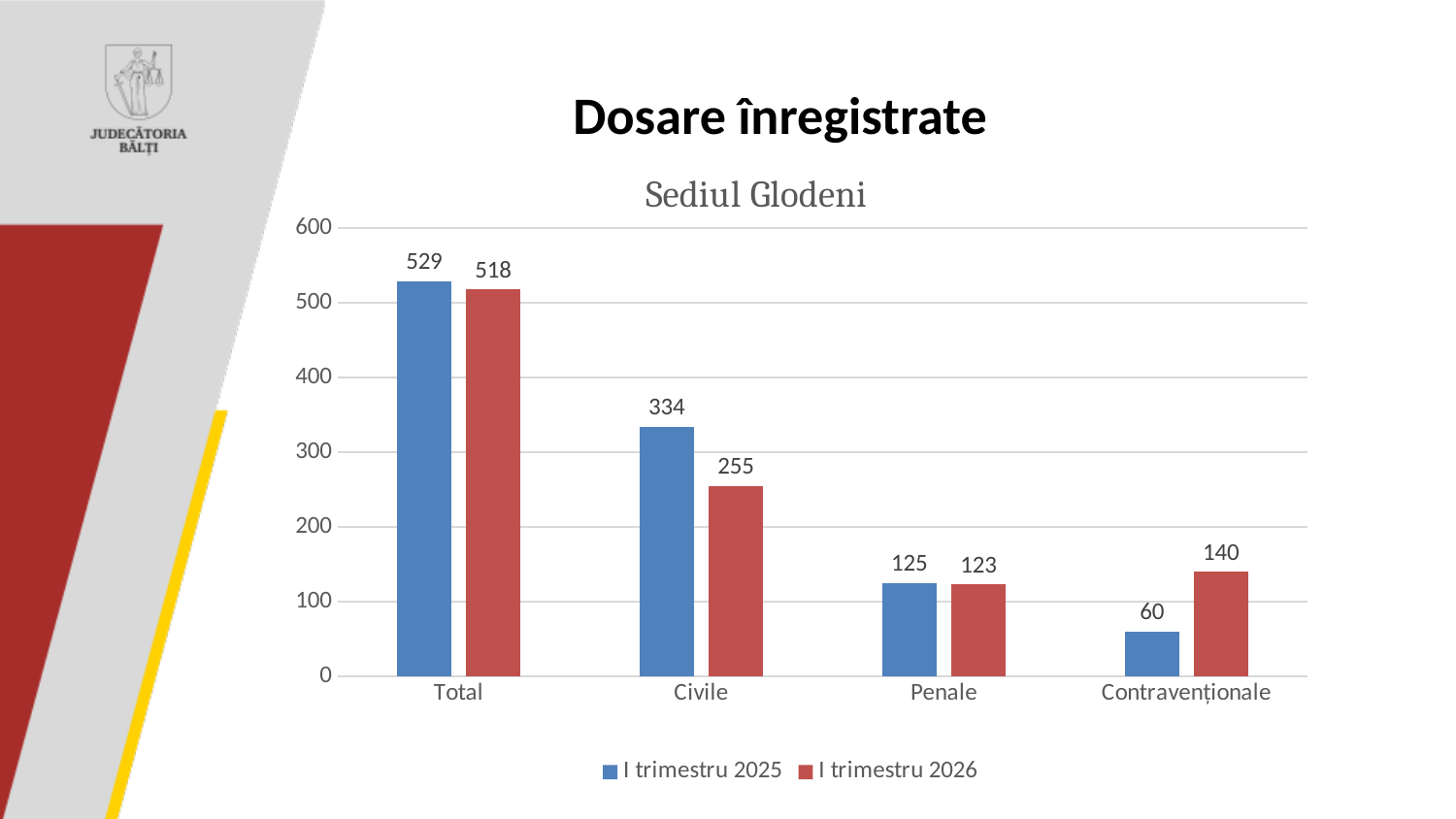
Which category has the lowest value in the I trimestru 2025 series? Contravenționale Which category has the highest value in the I trimestru 2026 series? Total What is the value for Contravenționale in the I trimestru 2026 series? 140 What is the value for Civile in the I trimestru 2025 series? 334 For Contravenționale, which series has the larger value: I trimestru 2025 or I trimestru 2026? I trimestru 2026 What kind of chart is shown on the slide? Bar chart What is the difference between the I trimestru 2025 and I trimestru 2026 values for Total? 11 How many categories are shown on the x axis? 4 What is the value for Penale in the I trimestru 2026 series? 123 What is the title of the chart? Sediul Glodeni What is the difference between the I trimestru 2025 and I trimestru 2026 values for Civile? 79 How many series does the legend list? 2